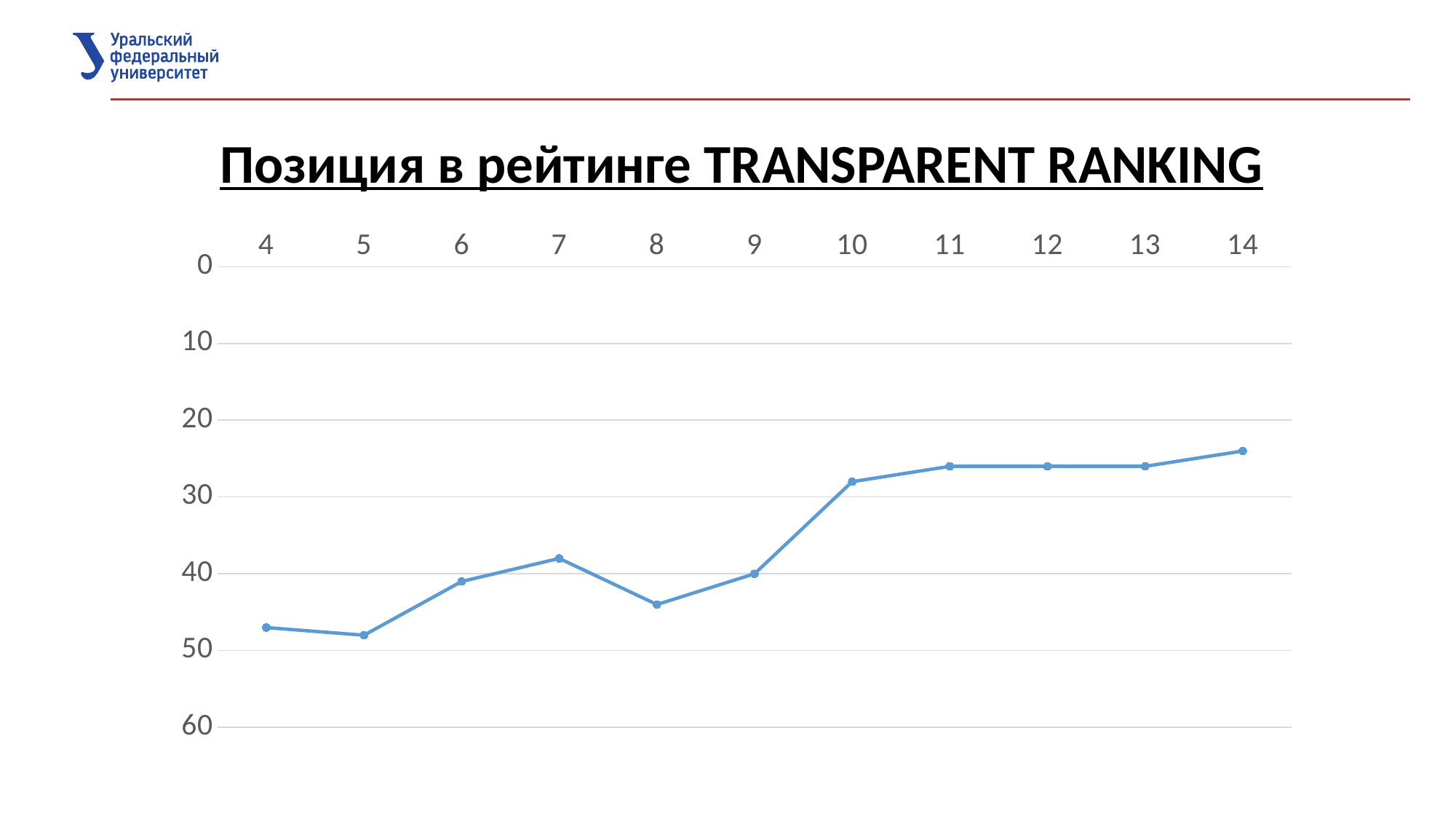
Which has the larger value, category 9 or category 10? 9 What kind of chart is shown on the slide? line chart Is the value for category 14 greater or less than 20? greater What is the value for category 9? 40 Which has the larger value, category 8 or category 9? 8 Is the value for category 10 greater or less than 30? less Is the value for category 4 greater or less than 40? greater What is the title of the chart? Позиция в рейтинге TRANSPARENT RANKING What value is shown at the top of the vertical axis? 0 How many data points are plotted on the line? 11